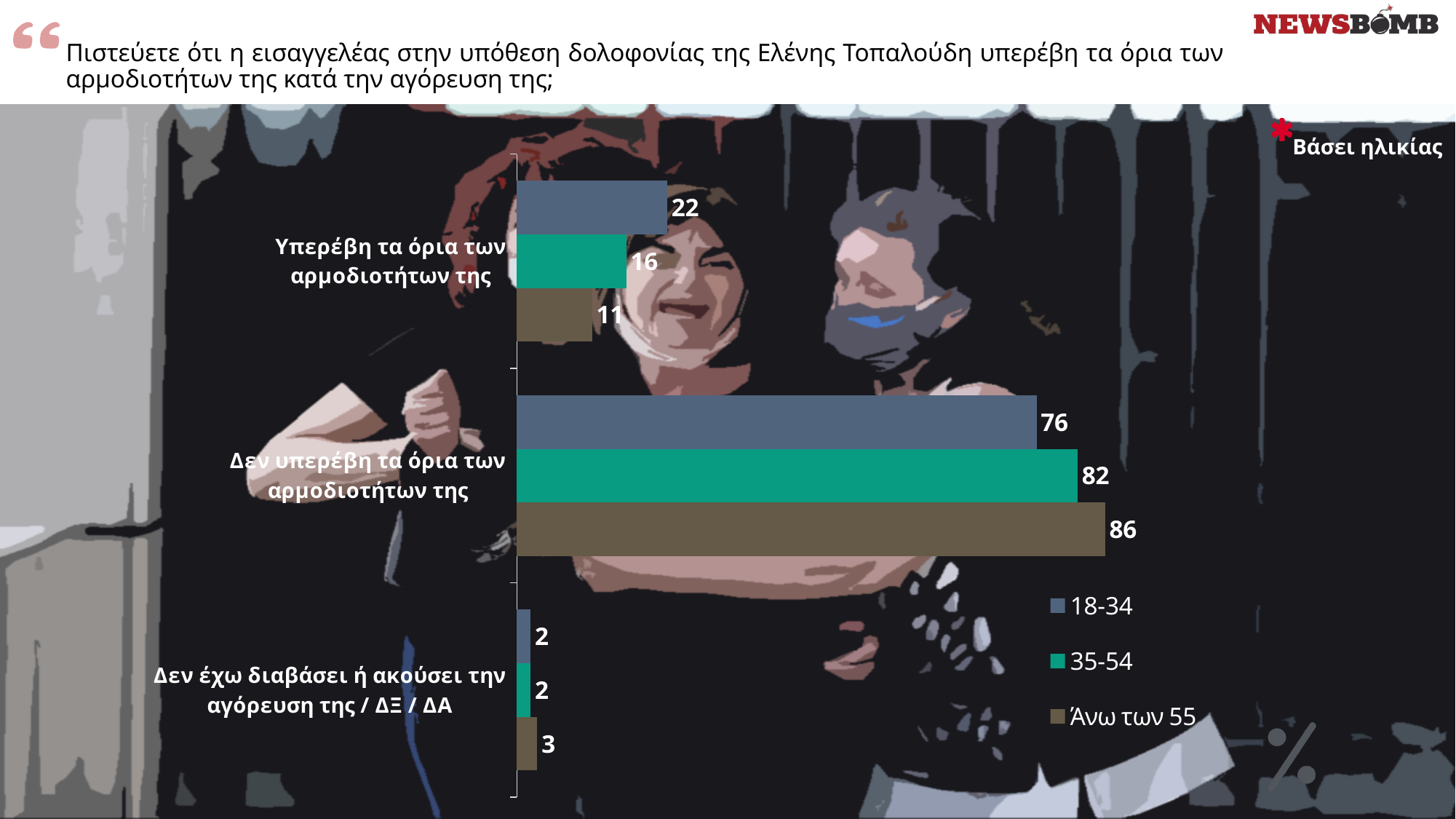
Which age group has the lowest value in the category "Υπερέβη τα όρια των αρμοδιοτήτων της"? Άνω των 55 What is the value for the 18-34 age group in the category "Υπερέβη τα όρια των αρμοδιοτήτων της"? 22 What is the difference between the "Άνω των 55" and 18-34 values in the category "Δεν υπερέβη τα όρια των αρμοδιοτήτων της"? 10 Which age group has the highest value in the category "Δεν υπερέβη τα όρια των αρμοδιοτήτων της"? Άνω των 55 Which age group is represented by the green bars in the legend? 35-54 Which is larger: the 18-34 value for "Υπερέβη τα όρια των αρμοδιοτήτων της" or the "Άνω των 55" value for the same category? 18-34 How many series does the legend list? 3 How many response categories are shown on the chart? 3 What is the value for the 35-54 age group in the category "Δεν υπερέβη τα όρια των αρμοδιοτήτων της"? 82 What is the value for the "Άνω των 55" age group in the category "Δεν έχω διαβάσει ή ακούσει την αγόρευση της / ΔΞ / ΔΑ"? 3 What is the difference between the 18-34 and 35-54 values in the category "Υπερέβη τα όρια των αρμοδιοτήτων της"? 6 What kind of chart is shown on the slide? Bar chart